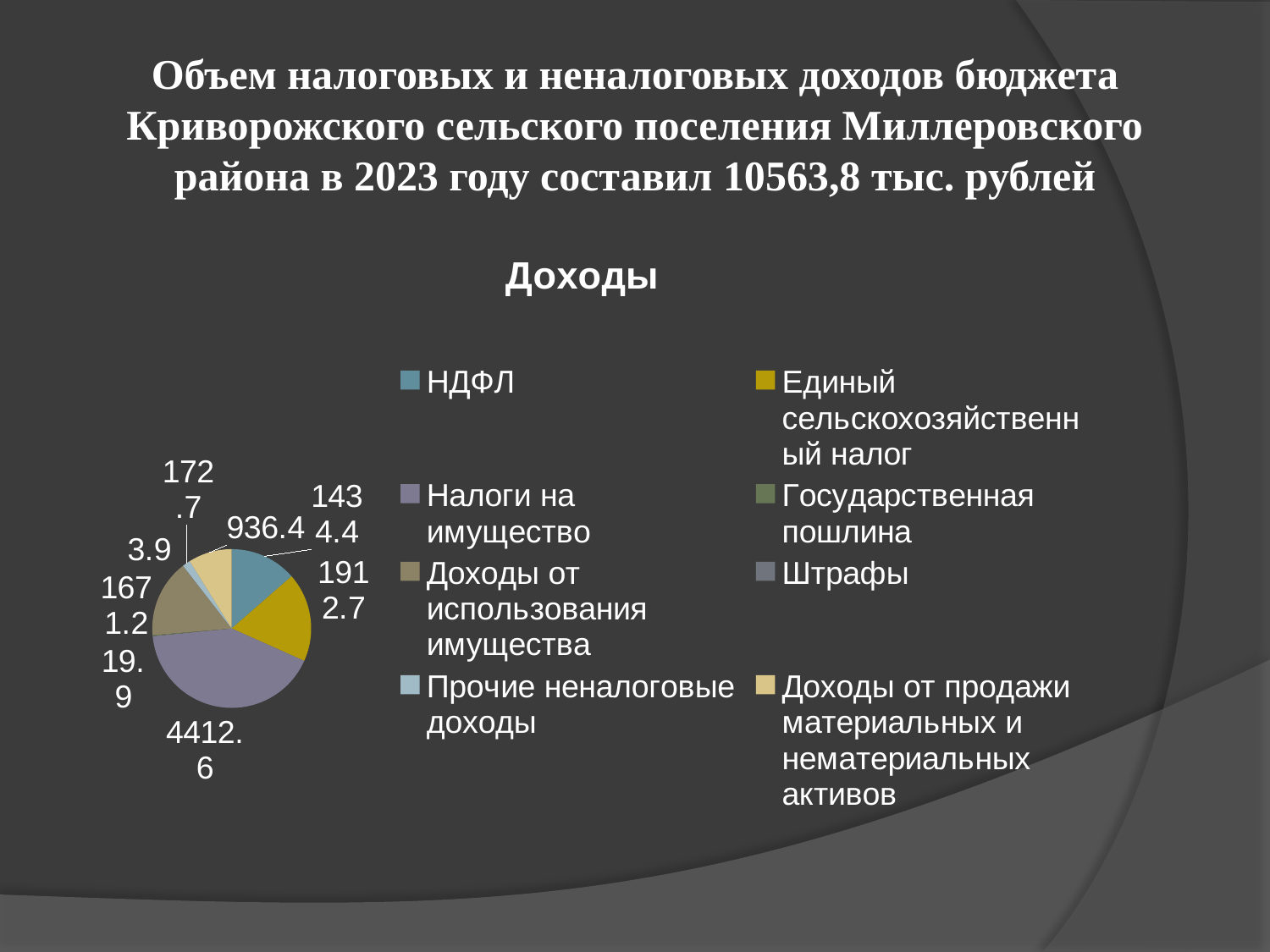
Which category has the largest slice of the pie? Налоги на имущество What is the title of the chart? Доходы What is the value for Доходы от использования имущества? 1671.2 What is the value for Налоги на имущество? 4412.6 What is the difference between Единый сельскохозяйственный налог and НДФЛ? 478.3 What is the smallest value labelled on the pie chart? 3.9 How many categories does the chart's legend list? 8 Which is larger, НДФЛ or Единый сельскохозяйственный налог? Единый сельскохозяйственный налог What is the value for НДФЛ? 1434.4 What is the value for Единый сельскохозяйственный налог? 1912.7 What is the value for Доходы от продажи материальных и нематериальных активов? 936.4 What kind of chart is shown on the slide? pie chart